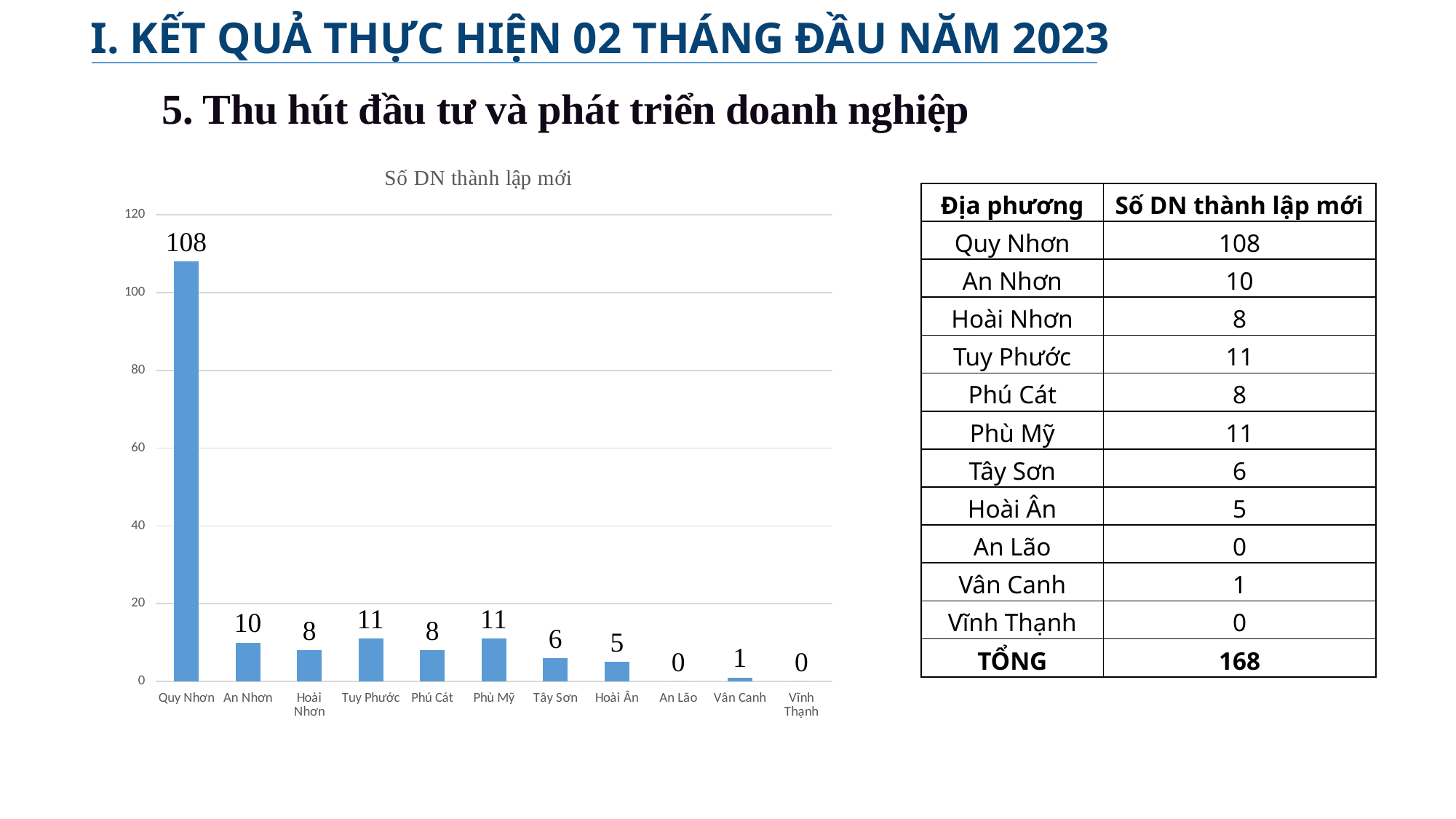
Which has a larger value, An Nhơn or Hoài Nhơn? An Nhơn What is the title of the chart? Số DN thành lập mới What is the value for Vân Canh in the chart? 1 What is the value for Hoài Ân in the chart? 5 How many localities (categories) are plotted in the chart? 11 Which locality has the highest value in the chart? Quy Nhơn What is the value for Quy Nhơn in the chart? 108 Is the value for Quy Nhơn greater or less than 100? greater What kind of chart is shown on the slide? bar chart What is the difference between the values for Phù Mỹ and Tây Sơn? 5 What is the difference between the values for Quy Nhơn and An Nhơn? 98 What is the value for Tuy Phước in the chart? 11